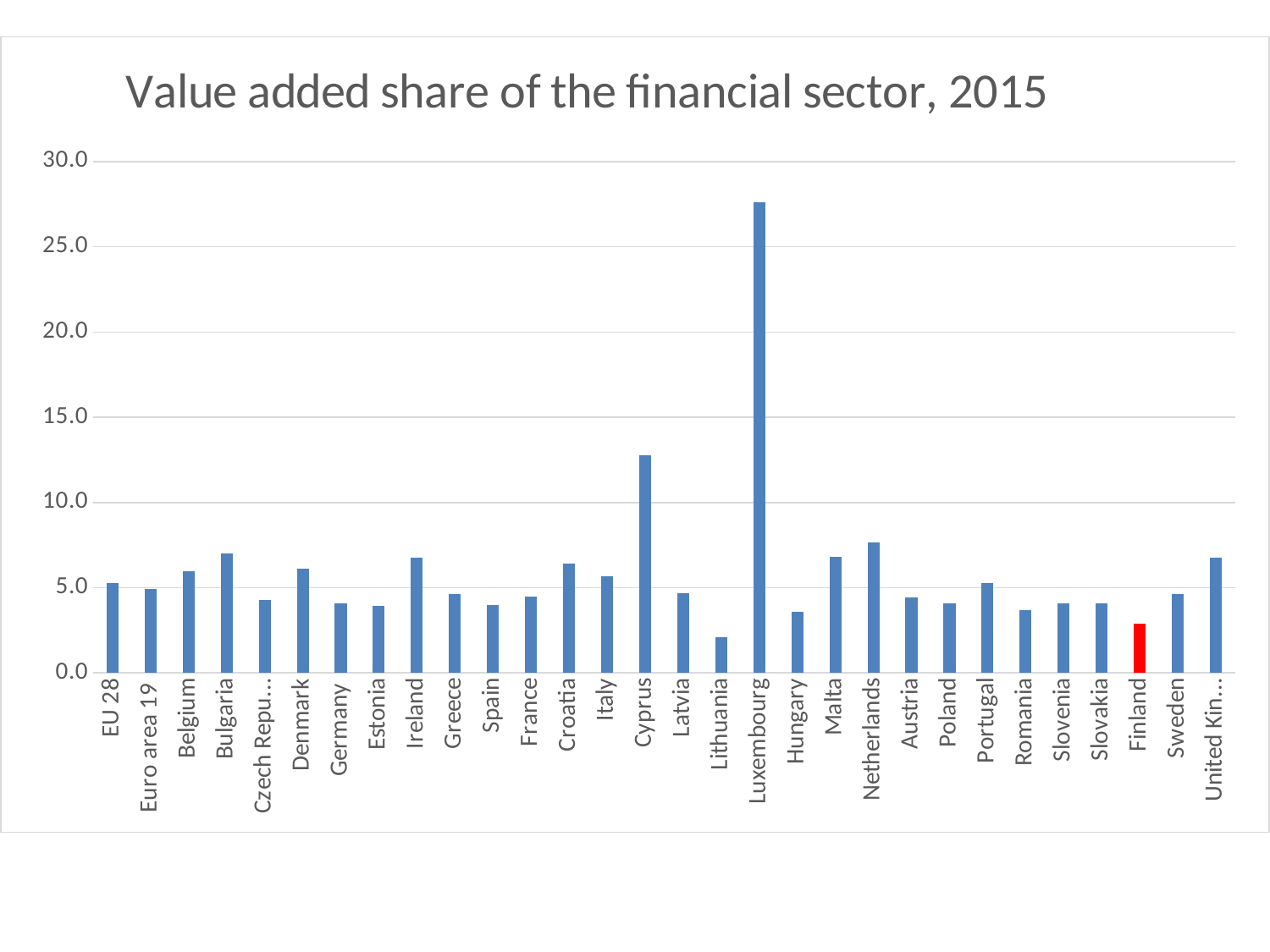
Which has a larger value, Bulgaria or Germany? Bulgaria Is the value for Luxembourg greater or less than 25.0? greater How many categories are plotted on the x axis? 30 Which country's bar is coloured red instead of blue? Finland Is the value for Netherlands greater or less than 5.0? greater What kind of chart is shown on the slide? Bar chart Is the value for Finland greater or less than 5.0? less What is the title of the chart? Value added share of the financial sector, 2015 Which country has the lowest value added share of the financial sector? Lithuania Which has a larger value, Cyprus or Netherlands? Cyprus Which country has the highest value added share of the financial sector? Luxembourg